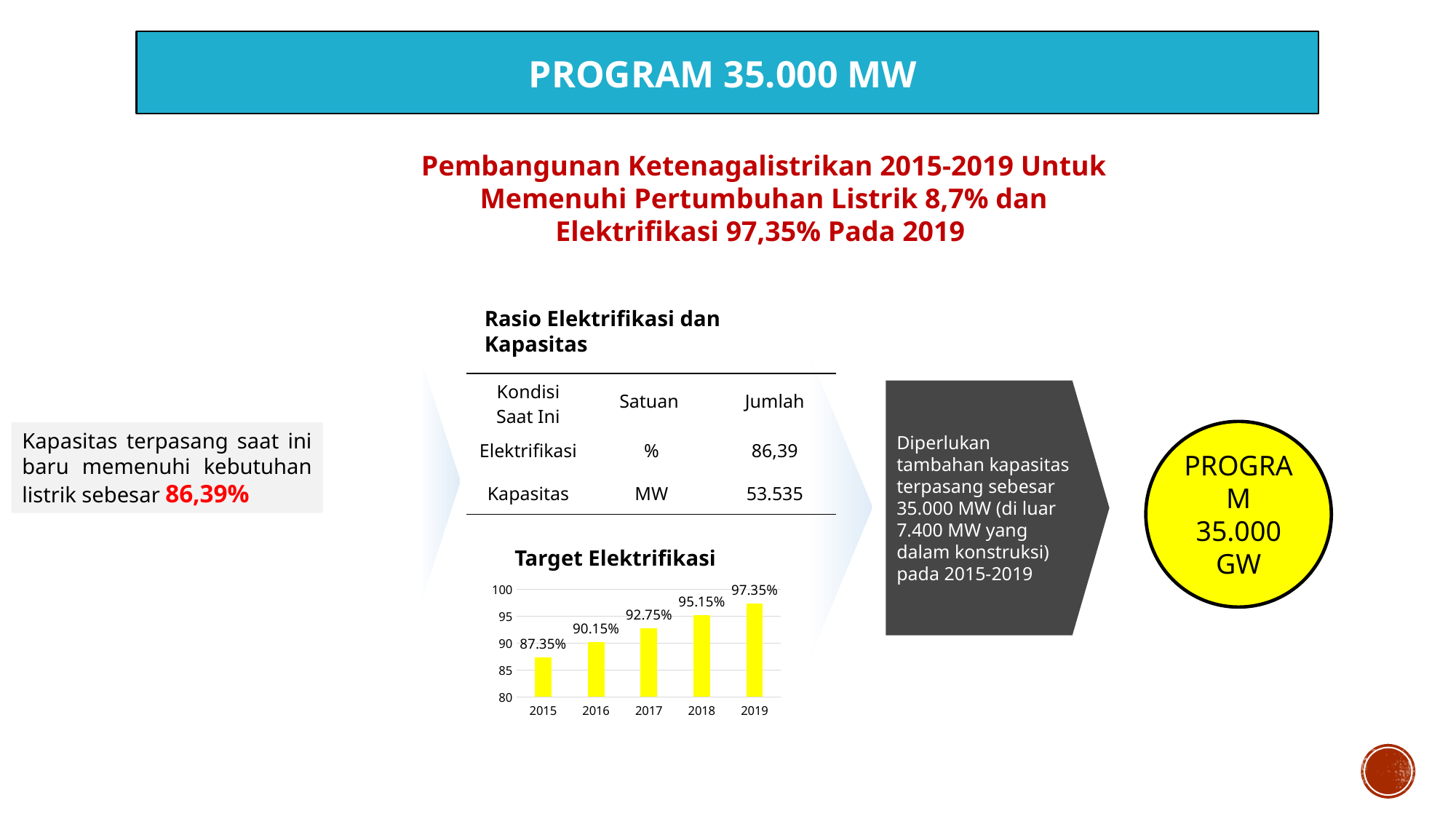
What is the target electrification value for 2019 in the Target Elektrifikasi chart? 97.35% What is the difference between the 2019 and 2015 values in the Target Elektrifikasi chart? 10% What is the target electrification value for 2017 in the Target Elektrifikasi chart? 92.75% In the Target Elektrifikasi chart, is the value for 2016 greater or less than 95? less Which year has the highest value in the Target Elektrifikasi chart? 2019 In the Target Elektrifikasi chart, is the value for 2018 larger than the value for 2016? Yes What is the target electrification value for 2015 in the Target Elektrifikasi chart? 87.35% What is the difference between the 2018 and 2017 values in the Target Elektrifikasi chart? 2.4% How many years are shown on the x axis of the Target Elektrifikasi chart? 5 Which year has the lowest value in the Target Elektrifikasi chart? 2015 Do the values in the Target Elektrifikasi chart rise or fall from 2015 to 2019? Rise What kind of chart is the Target Elektrifikasi chart? Bar chart